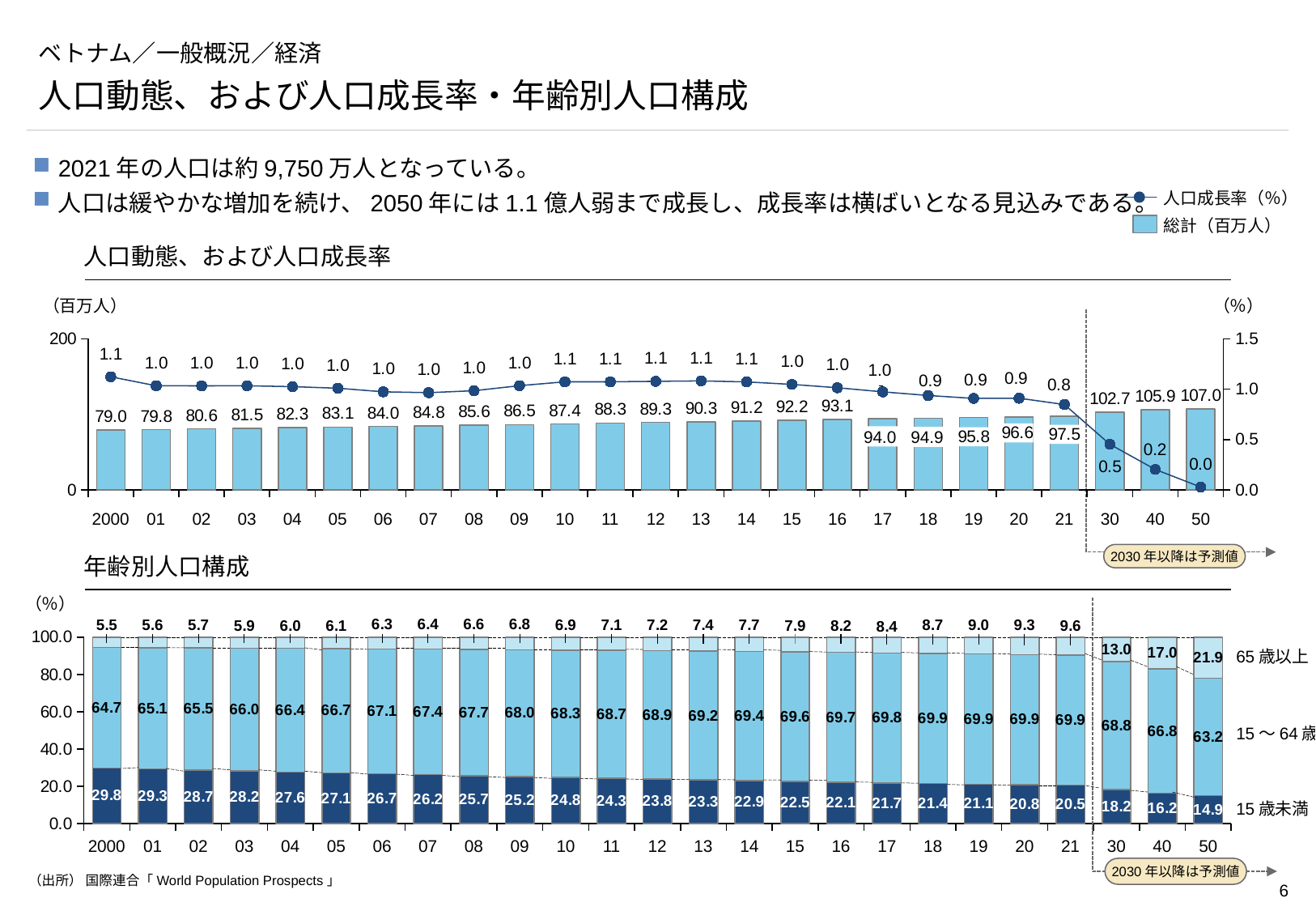
In the 人口動態、および人口成長率 chart, does the population growth rate rise or fall from 21 to 50? fall In the 年齢別人口構成 chart, does the 15 歳未満 share rise or fall from 2000 to 50? fall In the 人口動態、および人口成長率 chart, what is the population growth rate (%) for 2000? 1.1 In the 年齢別人口構成 chart, what is the share of 15 歳未満 in 2000? 29.8 In the 年齢別人口構成 chart, what is the difference in the 65 歳以上 share between 50 and 2000? 16.4 What kind of chart is the 年齢別人口構成 chart? stacked bar chart In the 年齢別人口構成 chart, what is the share of 65 歳以上 in 2021? 9.6 In the 人口動態、および人口成長率 chart, how many series does the legend list? 2 In the 人口動態、および人口成長率 chart, which year has the highest total population? 50 In the 人口動態、および人口成長率 chart, what is the total population (百万人) projected for 50 (2050)? 107.0 In the 人口動態、および人口成長率 chart, what is the total population (百万人) for 2021? 97.5 In the 人口動態、および人口成長率 chart, what is the difference in total population between 2000 and 2021? 18.5